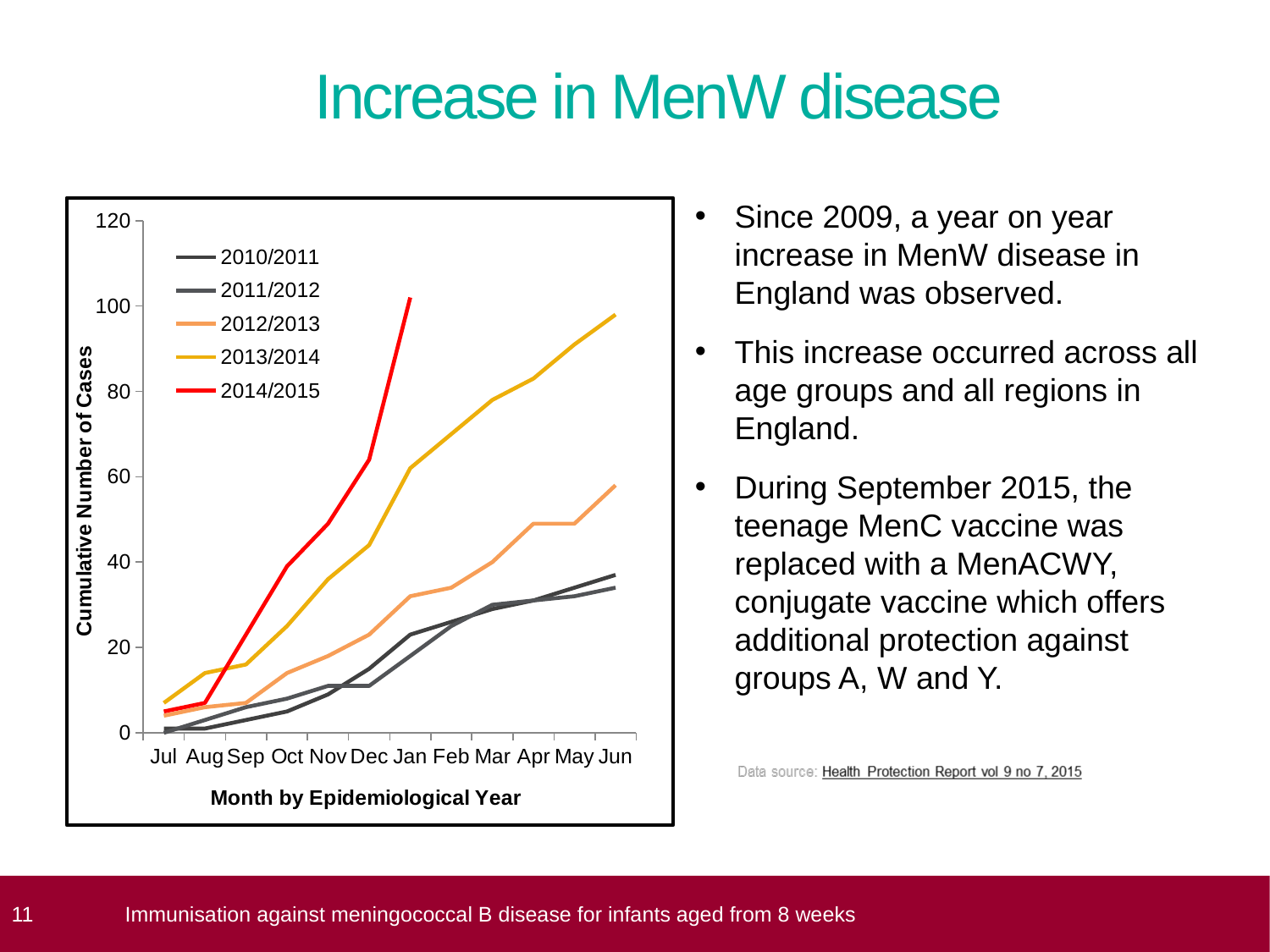
Is the value for 2012/2013 in Jun greater or less than 40? greater In Nov, which series has more cumulative cases, 2014/2015 or 2013/2014? 2014/2015 How many series does the legend list? 5 Is the value for 2010/2011 in Jun greater or less than 40? less What is the title of the y axis? Cumulative Number of Cases Do the cumulative number of cases for 2013/2014 rise or fall from Jul to Jun? rise Which series has the highest cumulative number of cases in Jun? 2013/2014 Is the value for 2014/2015 in Jan greater or less than 80? greater What kind of chart is shown on the slide? line chart Which series has the highest cumulative number of cases in Jan? 2014/2015 How many months are shown along the x axis? 12